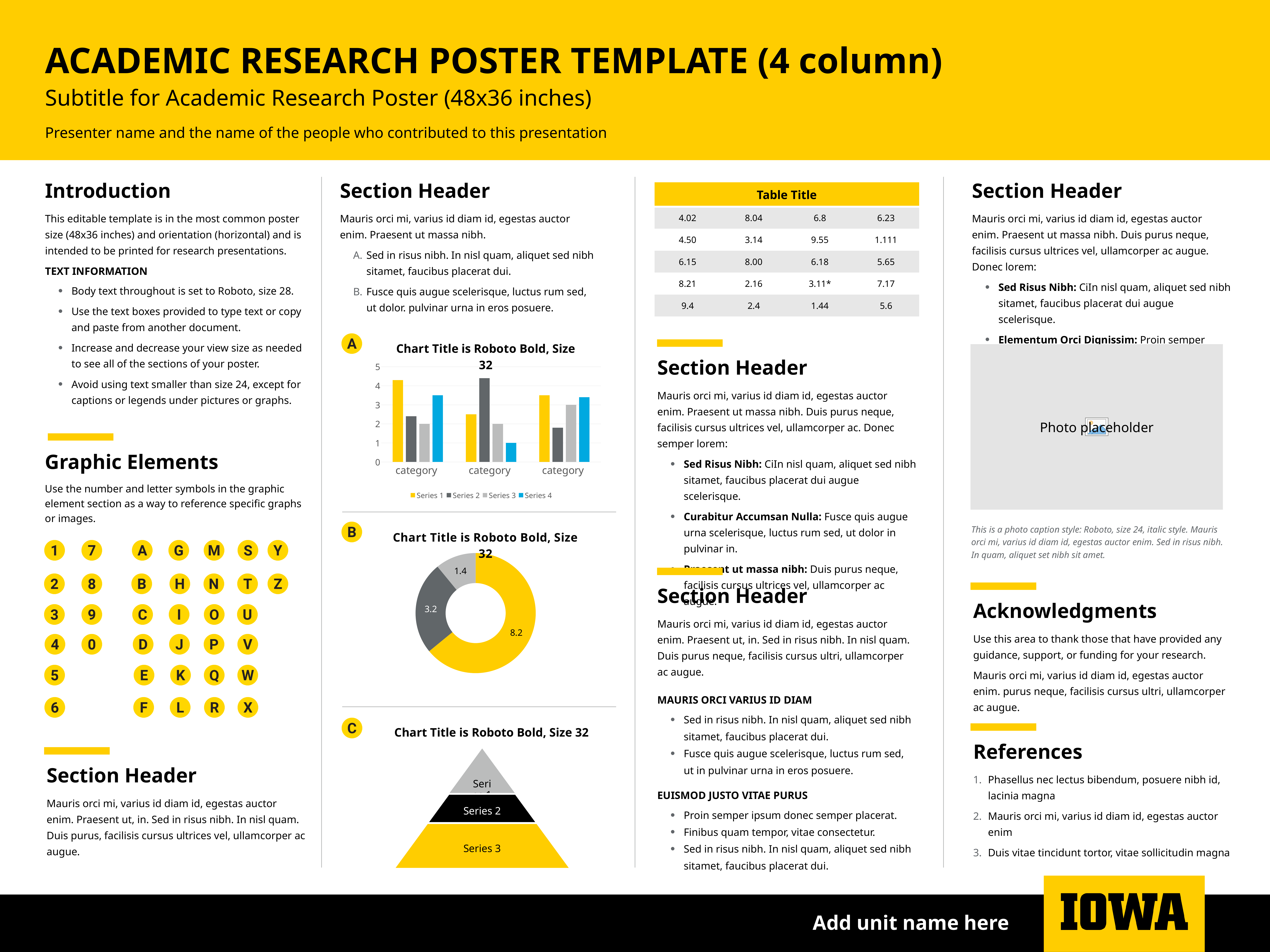
How many series does the legend of chart A list? 4 In chart C (the pyramid chart at the bottom of the second column), which series is the bottom level? Series 3 In chart A, is the Series 4 bar in the middle category group greater or less than 2? less How many categories are shown on the x axis of chart A? 3 How many slices does chart B have? 3 In chart A, is the Series 1 bar in the leftmost category group greater or less than 4? greater In chart B, what is the difference between the largest slice (8.2) and the slice labelled 3.2? 5.0 What is the value of the smallest slice in chart B? 1.4 In chart A, which series has the tallest bar in the middle category group? Series 2 What is the value of the largest slice in chart B? 8.2 What kind of chart is chart A (the top chart in the second column)? bar chart What kind of chart is chart B (the middle chart in the second column)? doughnut chart